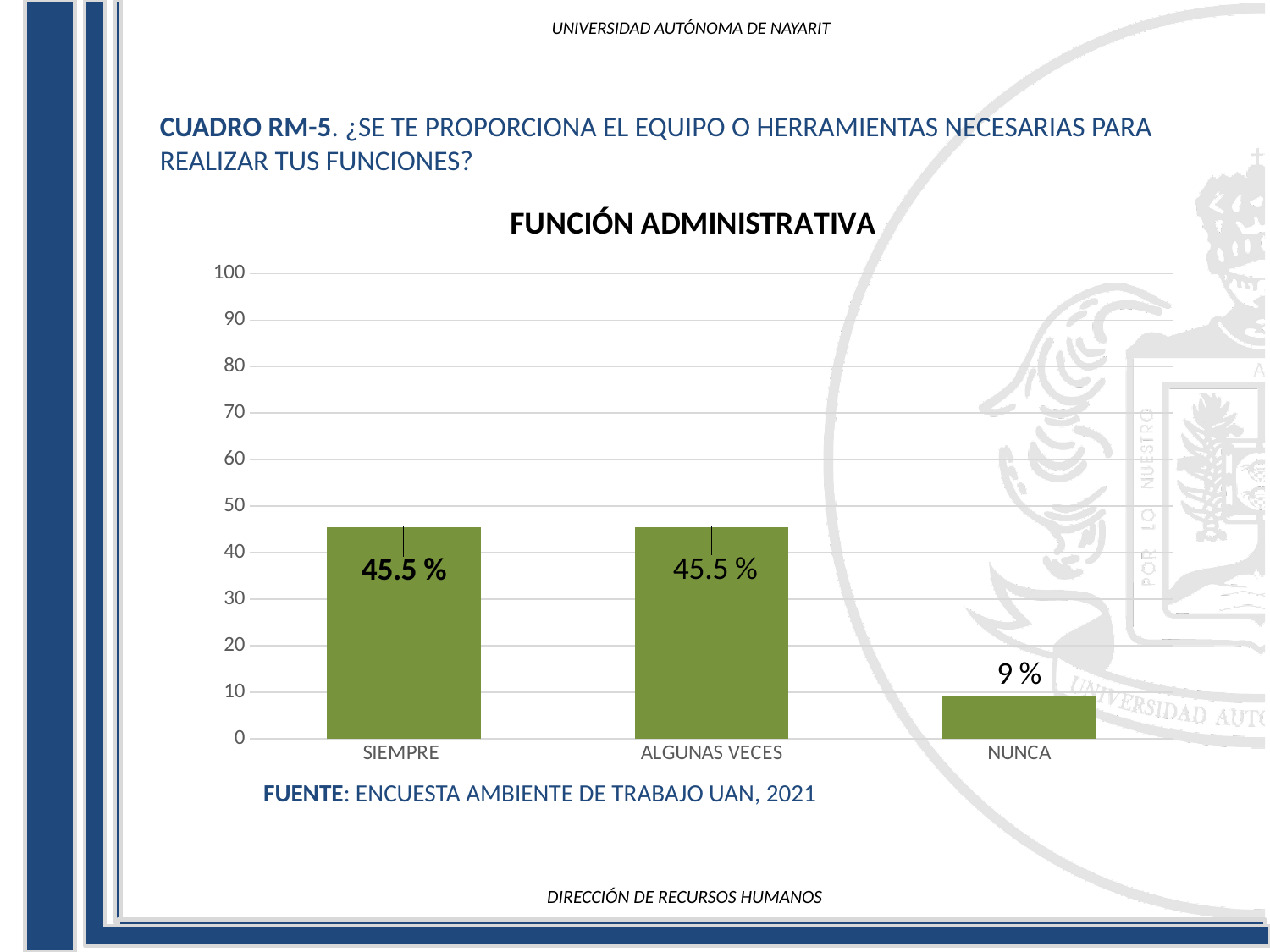
What is the difference between the value for ALGUNAS VECES and the value for NUNCA? 36.5 % What kind of chart is shown on the slide? bar chart What is the title of the chart? FUNCIÓN ADMINISTRATIVA Is the value for NUNCA greater or less than 20? less What is the value for NUNCA? 9 % Is the value for SIEMPRE greater or less than 40? greater What is the value for ALGUNAS VECES? 45.5 % Which category has the lowest value? NUNCA What is the value for SIEMPRE? 45.5 % What is the highest value shown on the y axis? 100 How many categories are shown on the x axis? 3 Which is larger, the value for SIEMPRE or the value for NUNCA? SIEMPRE